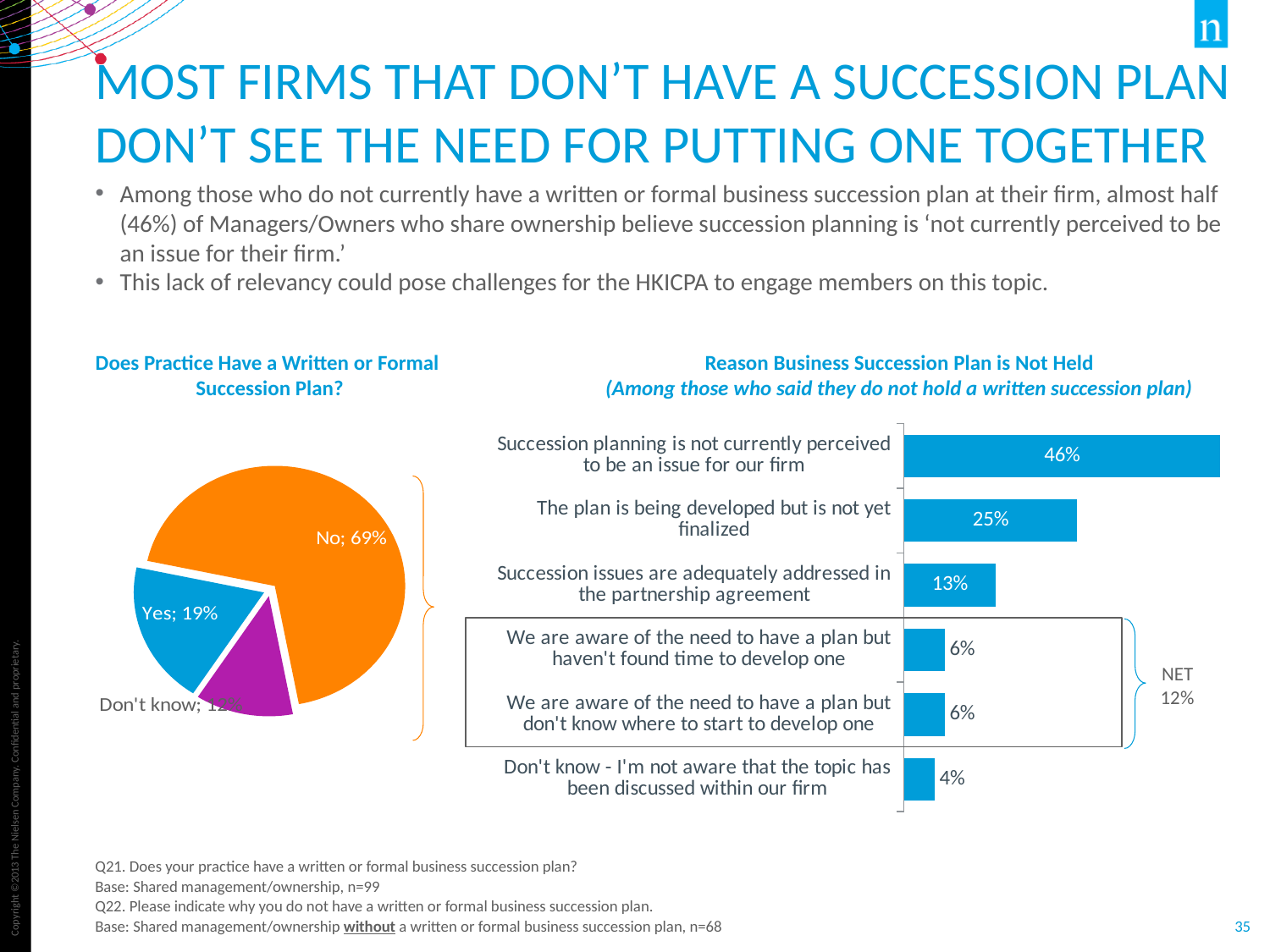
In the chart 'Reason Business Succession Plan is Not Held', what is the value for 'The plan is being developed but is not yet finalized'? 25% In the chart 'Reason Business Succession Plan is Not Held', what is the value for 'Succession issues are adequately addressed in the partnership agreement'? 13% What kind of chart is 'Reason Business Succession Plan is Not Held'? Bar chart In the pie chart 'Does Practice Have a Written or Formal Succession Plan?', what is the difference between the 'No' and 'Yes' shares? 50% In the chart 'Reason Business Succession Plan is Not Held', which reason has the lowest value? Don't know - I'm not aware that the topic has been discussed within our firm In the pie chart 'Does Practice Have a Written or Formal Succession Plan?', how many slices are there? 3 In the pie chart 'Does Practice Have a Written or Formal Succession Plan?', what share of respondents answered 'Yes'? 19% In the chart 'Reason Business Succession Plan is Not Held', how many reasons are listed? 6 In the chart 'Reason Business Succession Plan is Not Held', what is the difference between 'Succession planning is not currently perceived to be an issue for our firm' and 'The plan is being developed but is not yet finalized'? 21% In the pie chart 'Does Practice Have a Written or Formal Succession Plan?', which response has the largest slice? No In the pie chart 'Does Practice Have a Written or Formal Succession Plan?', what share of respondents answered 'No'? 69% In the chart 'Reason Business Succession Plan is Not Held', what is the value for 'Succession planning is not currently perceived to be an issue for our firm'? 46%